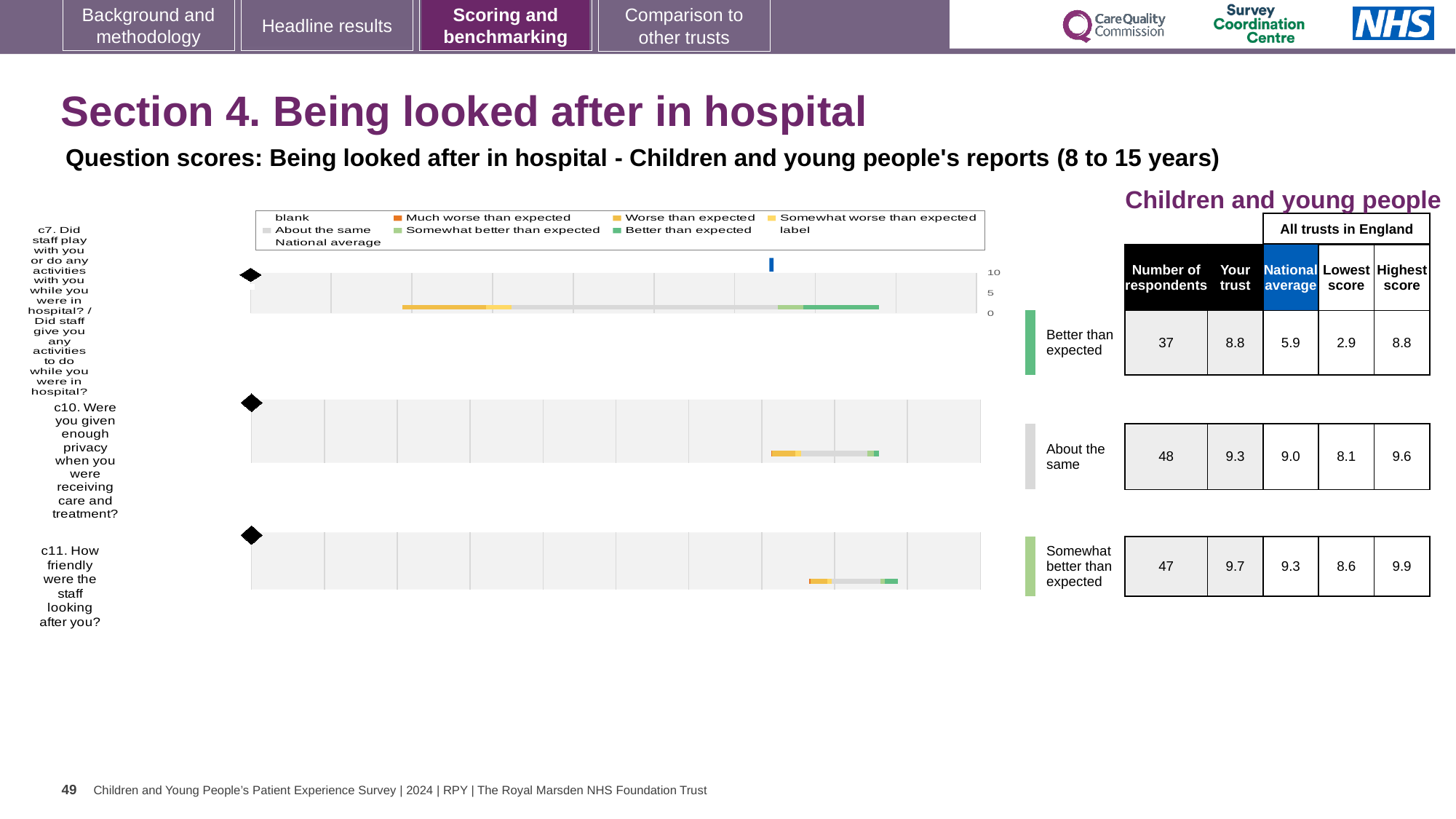
How many questions are plotted on the chart? 3 How many respondents answered question c10? 48 Which question has the highest 'Your trust' score? c11 Which question has the lowest national average score? c7 What is the national average score for question c10 (Were you given enough privacy when you were receiving care and treatment?)? 9.0 What is the highest score across all trusts in England for question c11 (How friendly were the staff looking after you?)? 9.9 What kind of chart is used to show the question scores? Bar chart What benchmark category is shown for question c7? Better than expected Which has the higher 'Your trust' score, question c10 or question c11? c11 What is the difference between the 'Your trust' score and the national average for question c7? 2.9 What is the lowest score across all trusts in England for question c7? 2.9 What is the 'Your trust' score for question c7 (Did staff play with you or do any activities with you while you were in hospital?)? 8.8